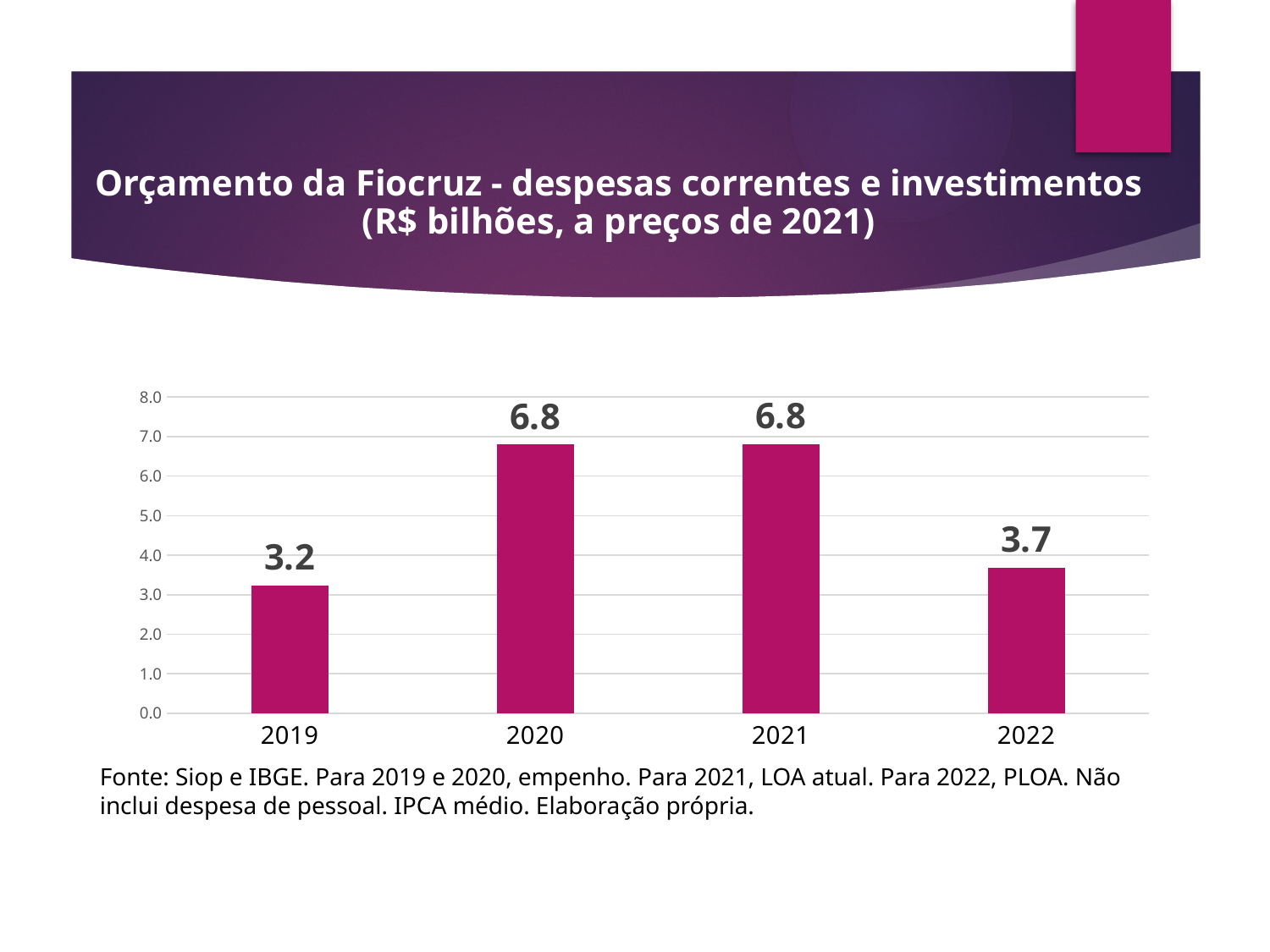
Which is larger, the value for 2022 or the value for 2019? 2022 What is the difference between the values for 2020 and 2019? 3.6 Is the value for 2021 greater or less than 5.0? greater How many years are shown on the x axis? 4 What is the value for 2022? 3.7 What kind of chart is shown on the slide? bar chart Is the value for 2019 greater or less than 4.0? less What is the title of the chart on the slide? Orçamento da Fiocruz - despesas correntes e investimentos (R$ bilhões, a preços de 2021) What is the value for 2020? 6.8 What is the difference between the values for 2021 and 2022? 3.1 Which year has the lowest value? 2019 What is the value for 2019? 3.2